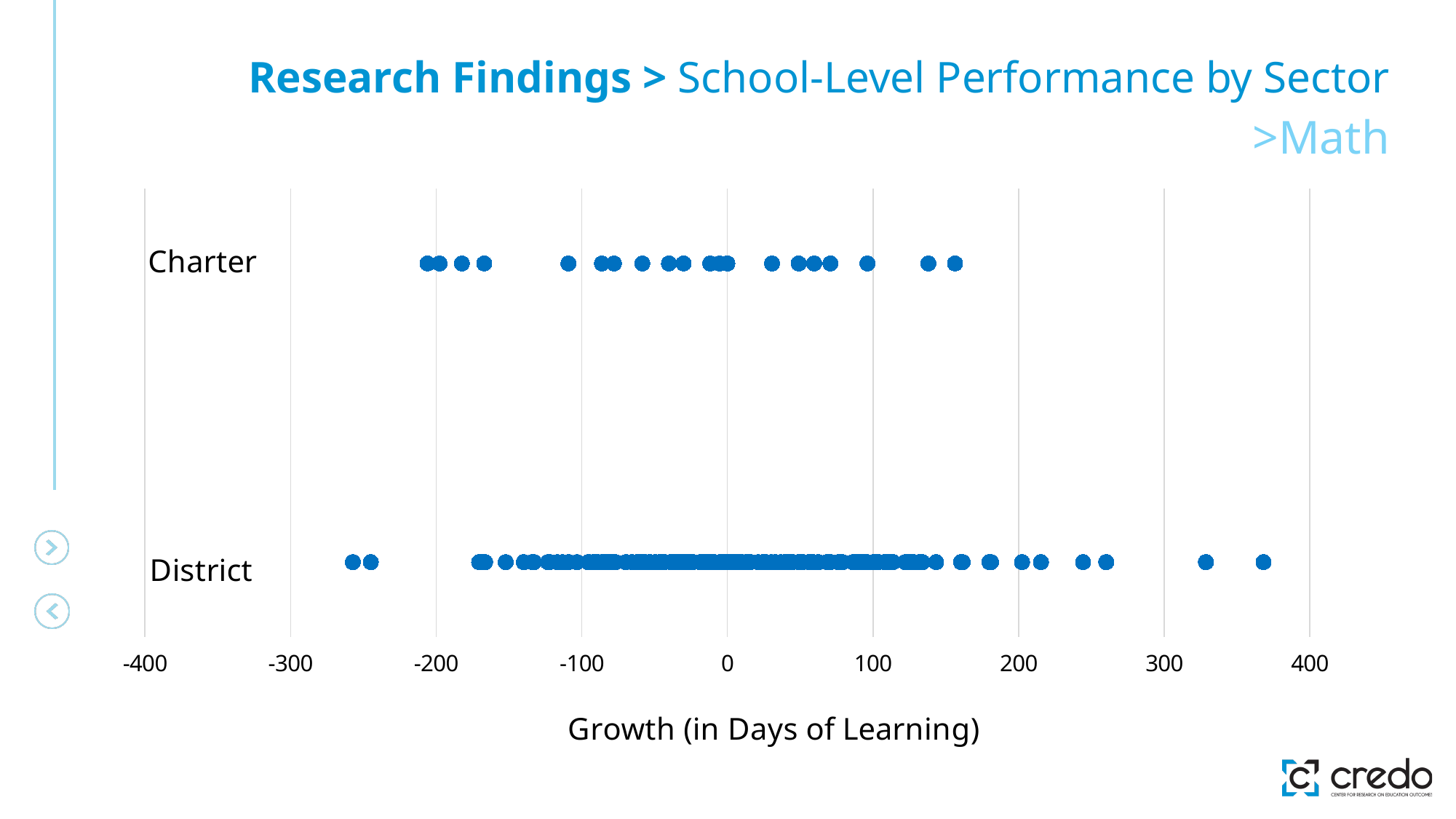
Is the lowest Charter value greater or less than -300? greater What kind of chart is shown on the slide? dot plot Is the highest District value greater or less than 300? greater How many sector categories are plotted on the vertical axis? 2 Is the highest Charter value greater or less than 200? less Which sector has the single highest growth value plotted? District Which sector has the single lowest growth value plotted? District Which subject does the chart report school-level performance for? Math What is the title of the horizontal axis? Growth (in Days of Learning) Which sector has more schools (dots) plotted? District